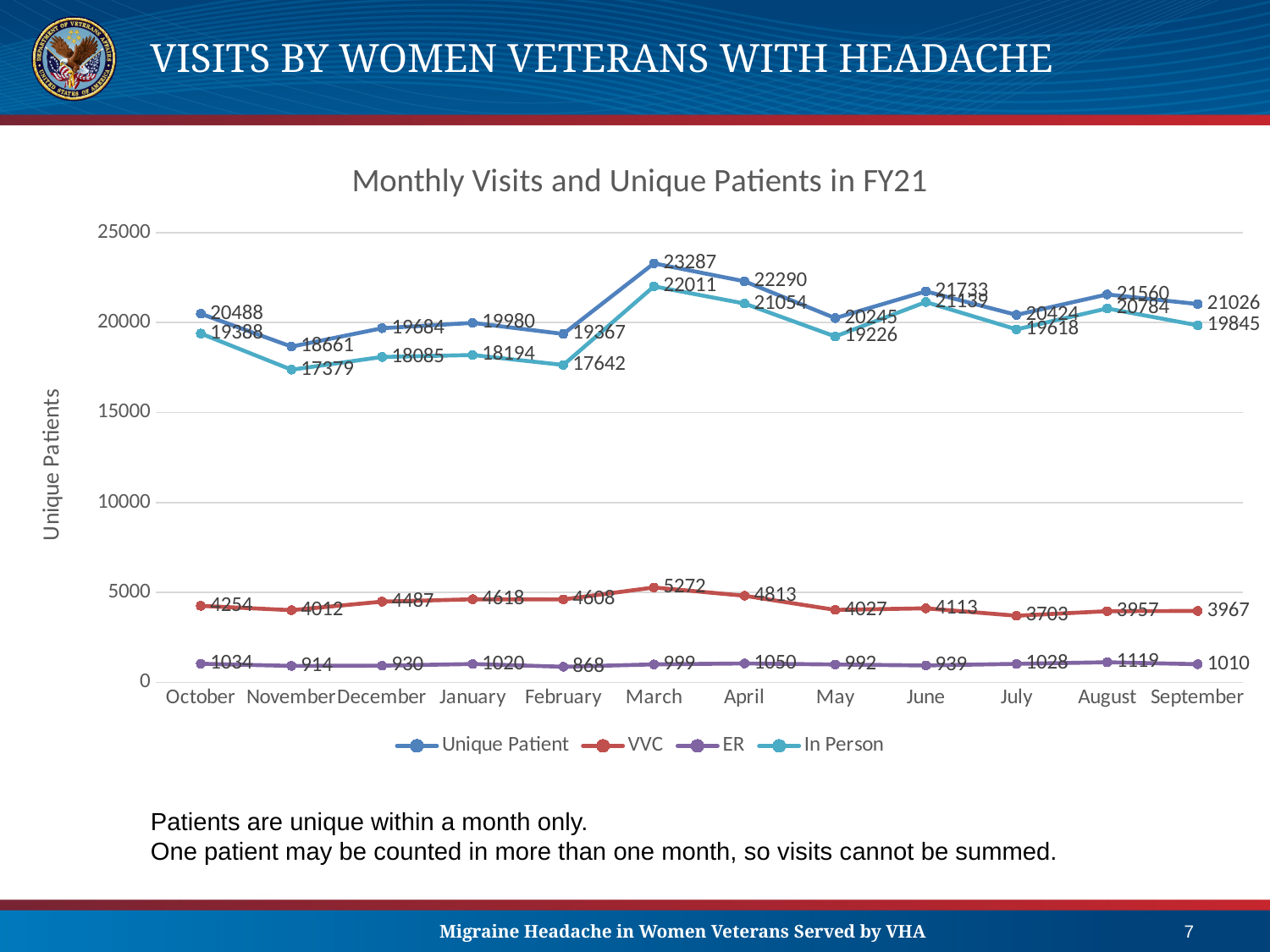
Which is larger, the ER value for August or the ER value for October? August What is the difference between the Unique Patient value and the In Person value in March? 1276 How many series does the legend list? 4 How many months are plotted along the x axis? 12 In which month is the ER series lowest? February What is the VVC value for July? 3703 What is the In Person value for October? 19388 What is the VVC value for March? 5272 In which month is the VVC series highest? March In which month is the Unique Patient series lowest? November What is the Unique Patient value for March? 23287 What kind of chart is shown on the slide? line chart